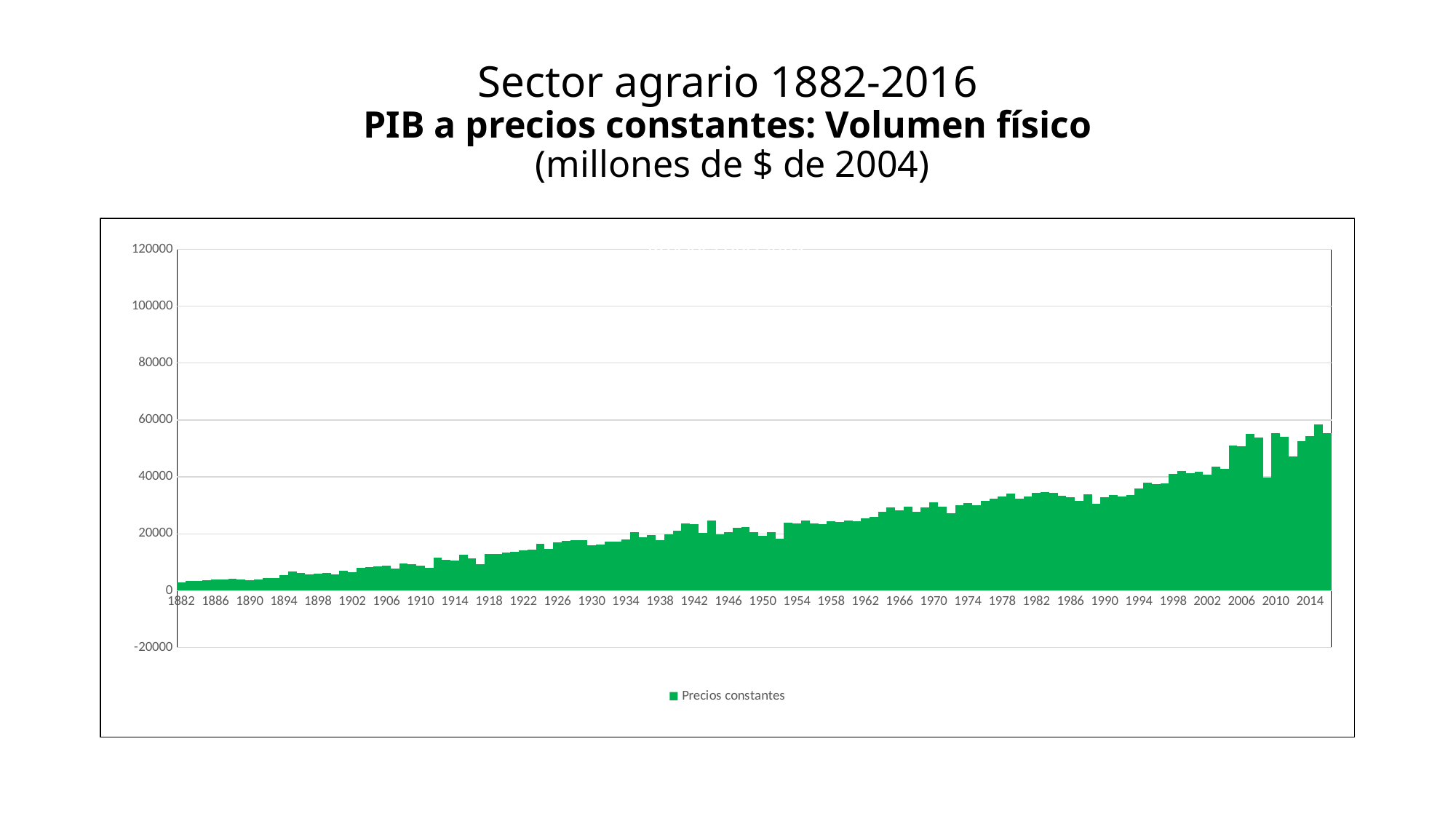
Which year has the larger value, 1882 or 2014? 2014 What is the name of the series shown in the legend? Precios constantes Is the value for 2010 greater or less than 60000? less Do the values generally rise or fall from 1882 to 2016? Rise What colour are the bars in the chart? Green Is the value for 1930 greater or less than 20000? less Is the value for 1970 greater or less than 20000? greater What kind of chart is shown on the slide? Bar chart How many series does the legend list? 1 Which year has the larger value, 1902 or 1942? 1942